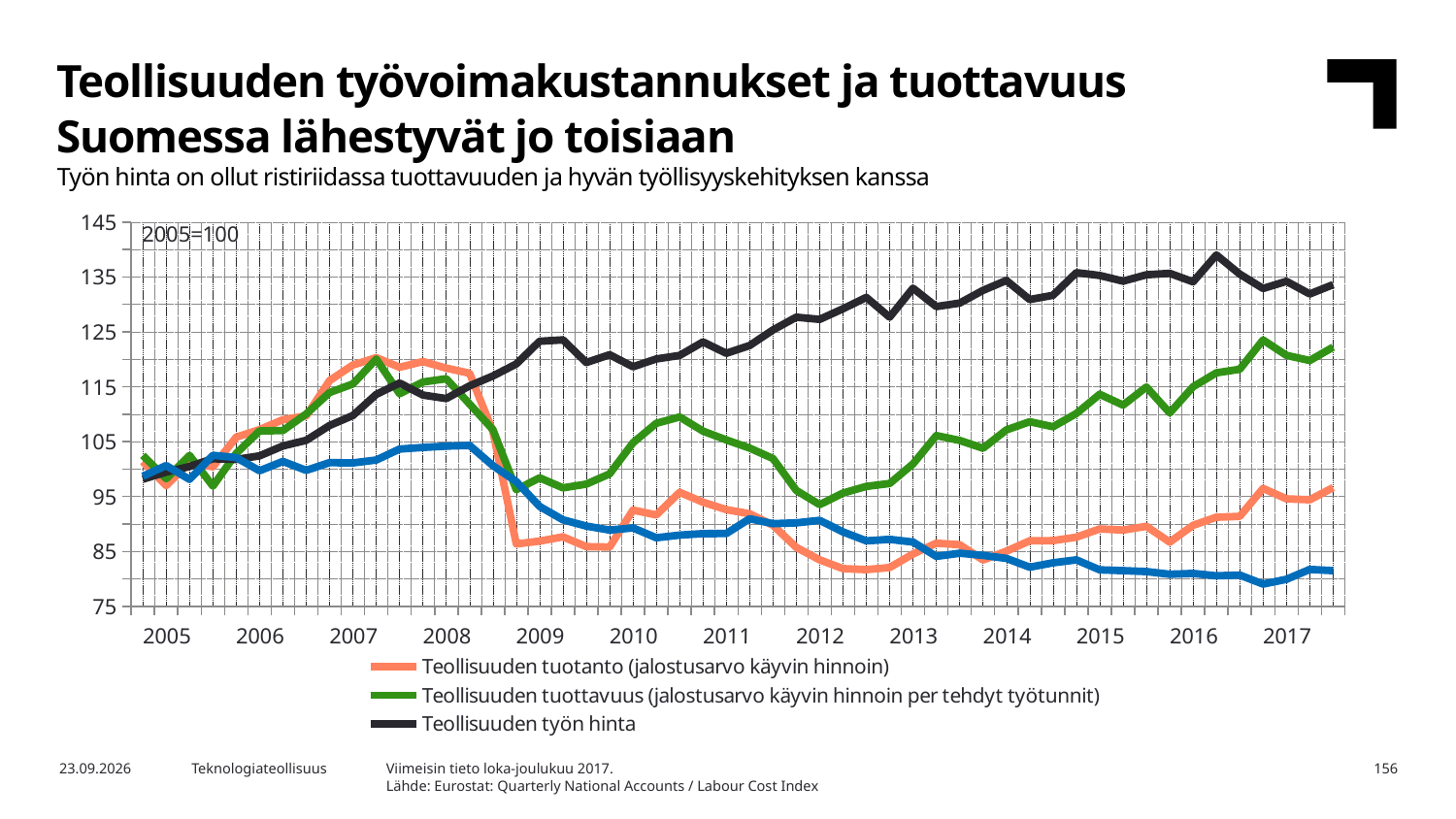
Which series has the highest value at the end of 2017? Teollisuuden työn hinta How many series does the legend list? 3 In 2016, which is higher: Teollisuuden työn hinta or Teollisuuden tuotanto? Teollisuuden työn hinta What kind of chart is shown on the slide? line chart What colour is the line for Teollisuuden työn hinta? black Is the value for Teollisuuden tuotanto in 2008 greater or less than 115? greater Is the value for Teollisuuden tuottavuus in 2017 greater or less than 115? greater In 2009, which is higher: Teollisuuden tuottavuus or Teollisuuden tuotanto? Teollisuuden tuottavuus Does Teollisuuden työn hinta generally rise or fall from 2005 to 2017? rise What base year and index value is noted in the top-left corner of the chart? 2005=100 Is the value for Teollisuuden työn hinta in 2017 greater or less than 125? greater